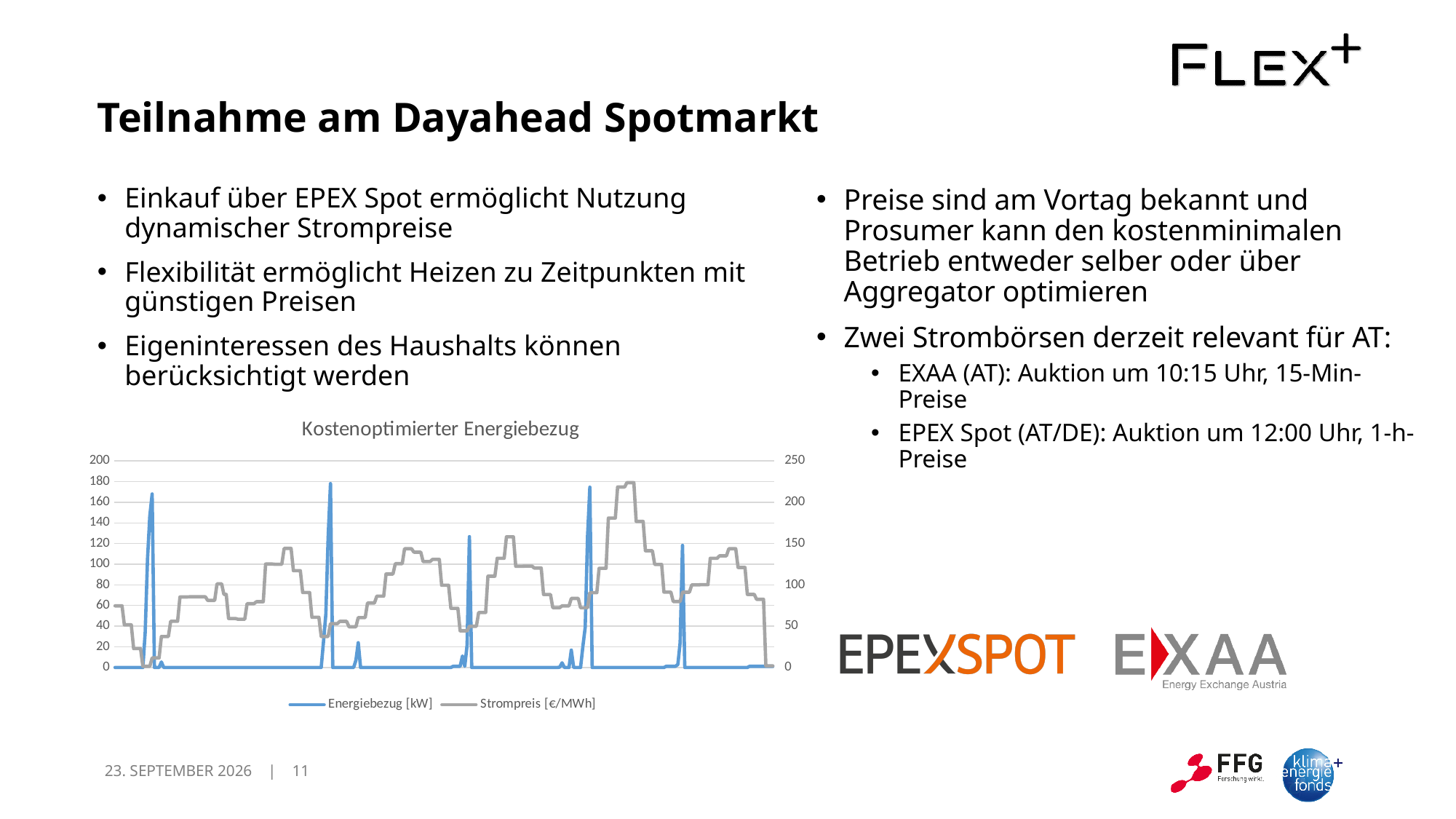
Is the highest value of the Strompreis [€/MWh] series greater or less than 200 on the right axis? greater Is the highest value of the Energiebezug [kW] series greater or less than 200 on the left axis? less What is the title of the chart? Kostenoptimierter Energiebezug Is the highest value of the Energiebezug [kW] series greater or less than 160 on the left axis? greater How many series does the legend of the chart list? 2 Which series is drawn in blue in the chart? Energiebezug [kW] What kind of chart is shown on the slide? line chart